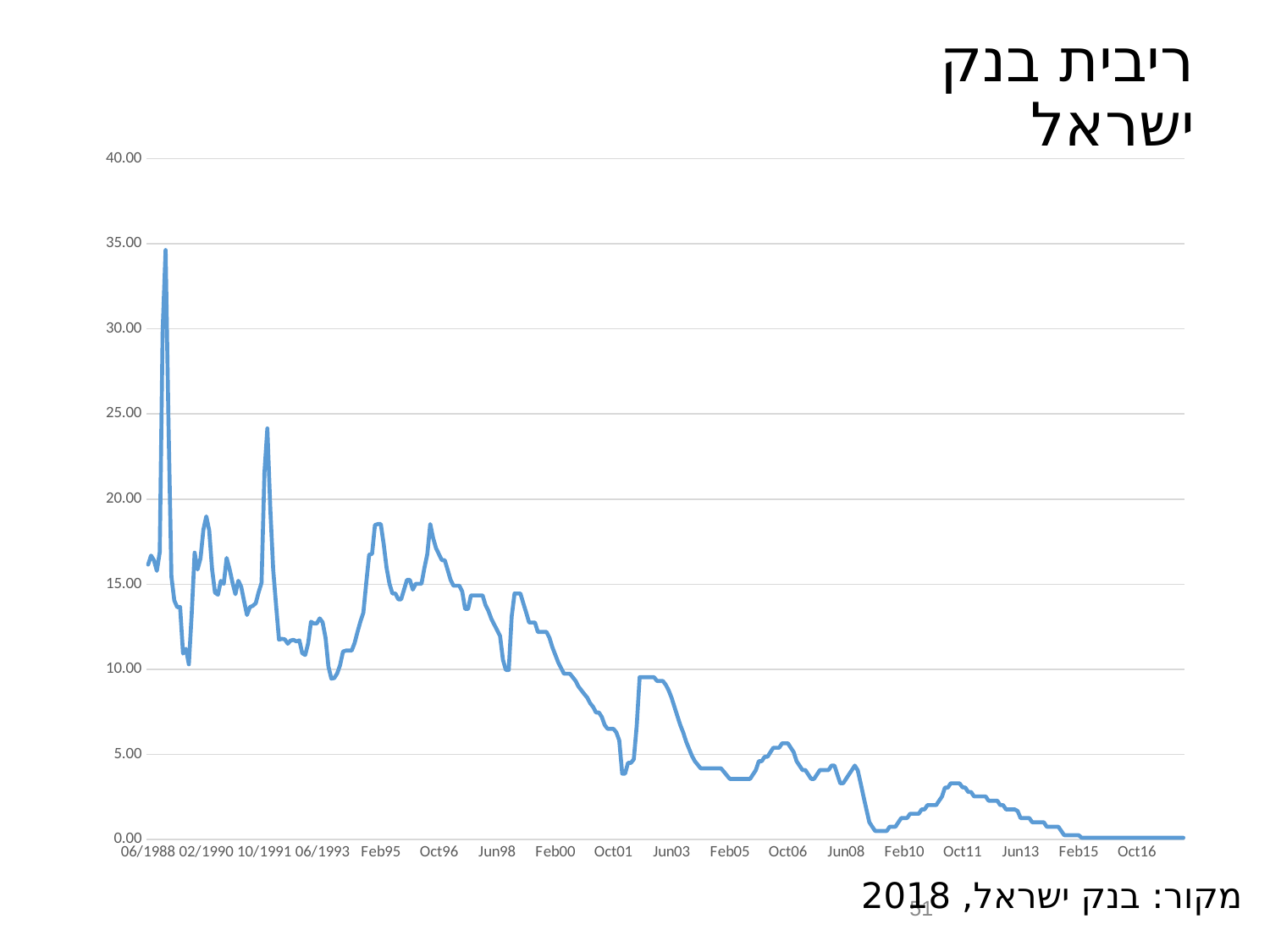
What is the first date label on the x axis? 06/1988 Is the value at Feb95 greater or less than 10.00? greater Overall, do the values rise or fall from 06/1988 to Oct16? fall Is the value at Feb10 greater or less than 5.00? less Is the value at Oct16 greater or less than 5.00? less What kind of chart is shown on the slide? line chart Which is larger, the value at Oct96 or the value at Oct16? Oct96 What is the highest value shown on the y axis? 40.00 How many date labels are shown on the x axis? 18